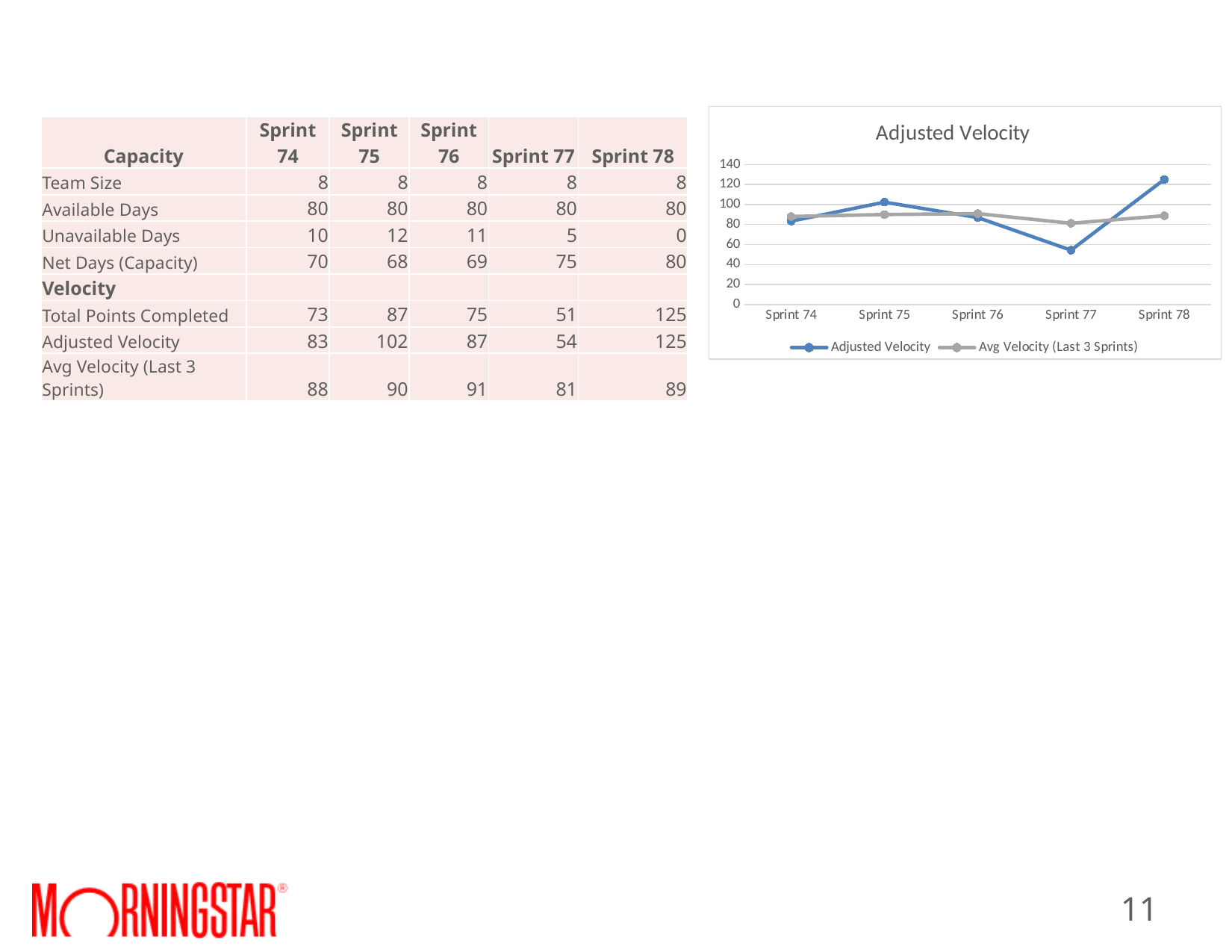
In which sprint is the Avg Velocity (Last 3 Sprints) lowest? Sprint 77 Is the Adjusted Velocity for Sprint 77 greater or less than 60? less In Sprint 77, which is larger: Adjusted Velocity or Avg Velocity (Last 3 Sprints)? Avg Velocity (Last 3 Sprints) In Sprint 75, which is larger: Adjusted Velocity or Avg Velocity (Last 3 Sprints)? Adjusted Velocity Is the Adjusted Velocity for Sprint 78 greater or less than 100? greater In which sprint is the Adjusted Velocity highest? Sprint 78 How many series does the legend of the Adjusted Velocity chart list? 2 What kind of chart is shown on the slide? line chart Does the Adjusted Velocity rise or fall from Sprint 77 to Sprint 78? rise In which sprint is the Adjusted Velocity lowest? Sprint 77 How many sprints are plotted along the x axis of the Adjusted Velocity chart? 5 What is the title of the chart on the slide? Adjusted Velocity